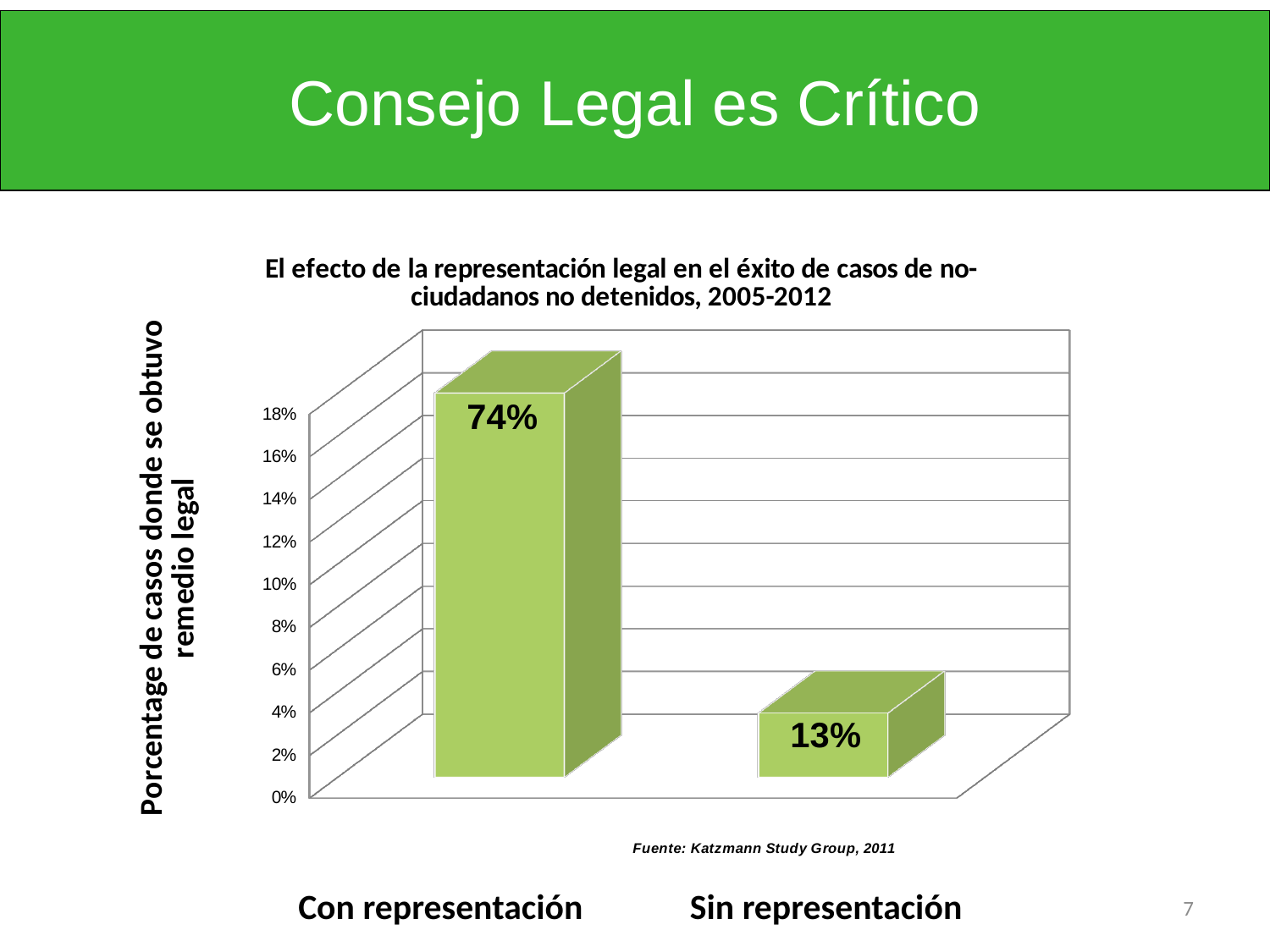
Which category has the highest value? Con representación Which is larger, the value for Con representación or the value for Sin representación? Con representación What is the value for Con representación? 74% What kind of chart is shown on the slide? Bar chart What is the title of the chart? El efecto de la representación legal en el éxito de casos de no-ciudadanos no detenidos, 2005-2012 What is the value for Sin representación? 13% What source is cited below the chart? Katzmann Study Group, 2011 Which category has the lowest value? Sin representación How many categories are shown in the chart? 2 What is the difference between the values for Con representación and Sin representación? 61%